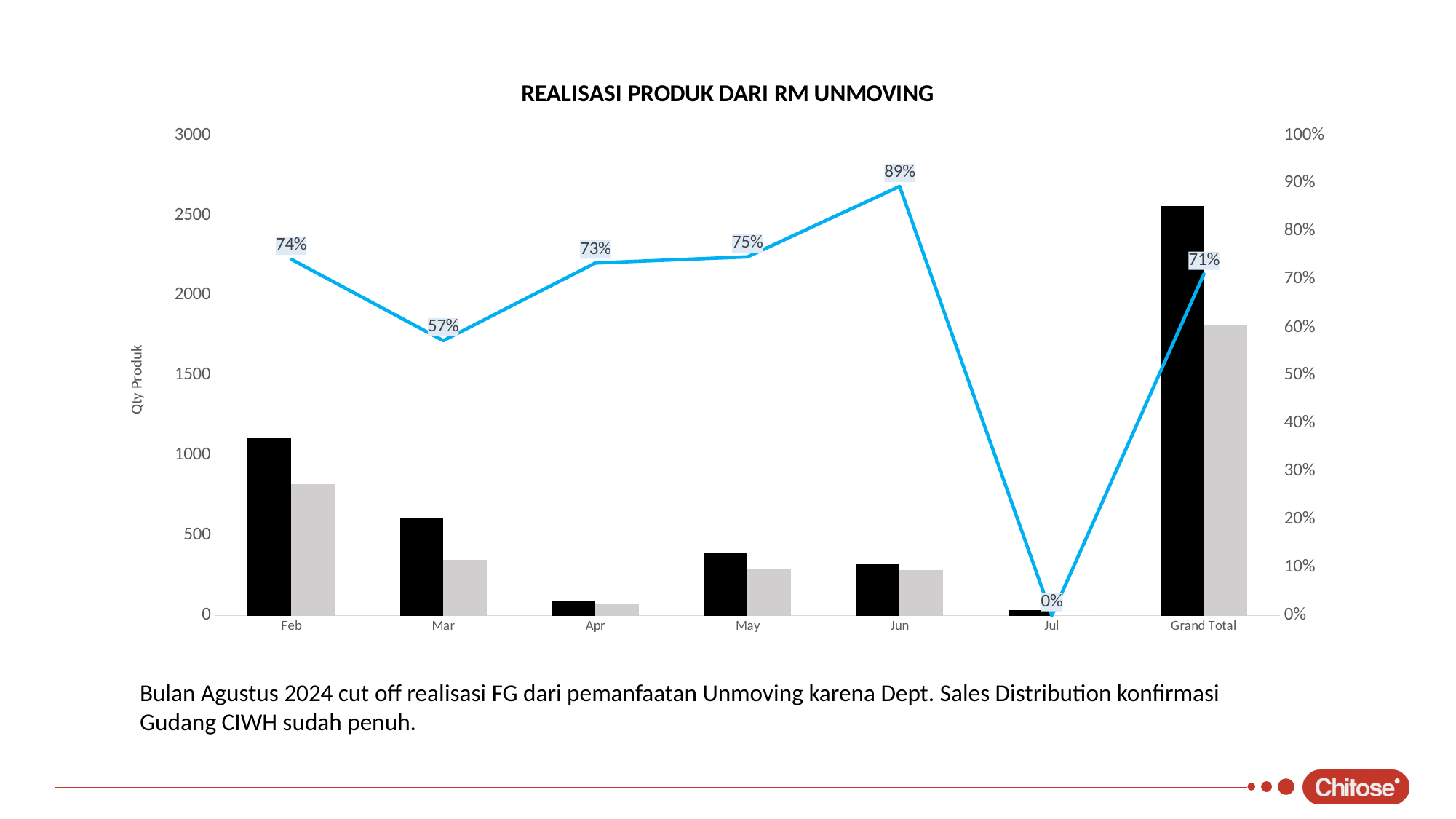
Which has a higher percentage on the line, May or Apr? May What is the percentage shown for Mar on the line? 57% What is the title of the chart? REALISASI PRODUK DARI RM UNMOVING What is the percentage shown for Jun on the line? 89% Is the value of the grey bar for Grand Total greater or less than 2000? less What is the percentage shown for Grand Total on the line? 71% What is the percentage shown for Feb on the line? 74% Is the value of the black bar for Feb greater or less than 1000? greater What is the difference between the Jun percentage and the Mar percentage on the line? 32% How many categories are shown on the x axis? 7 Which category has the lowest percentage on the line? Jul Which category has the highest percentage on the line? Jun